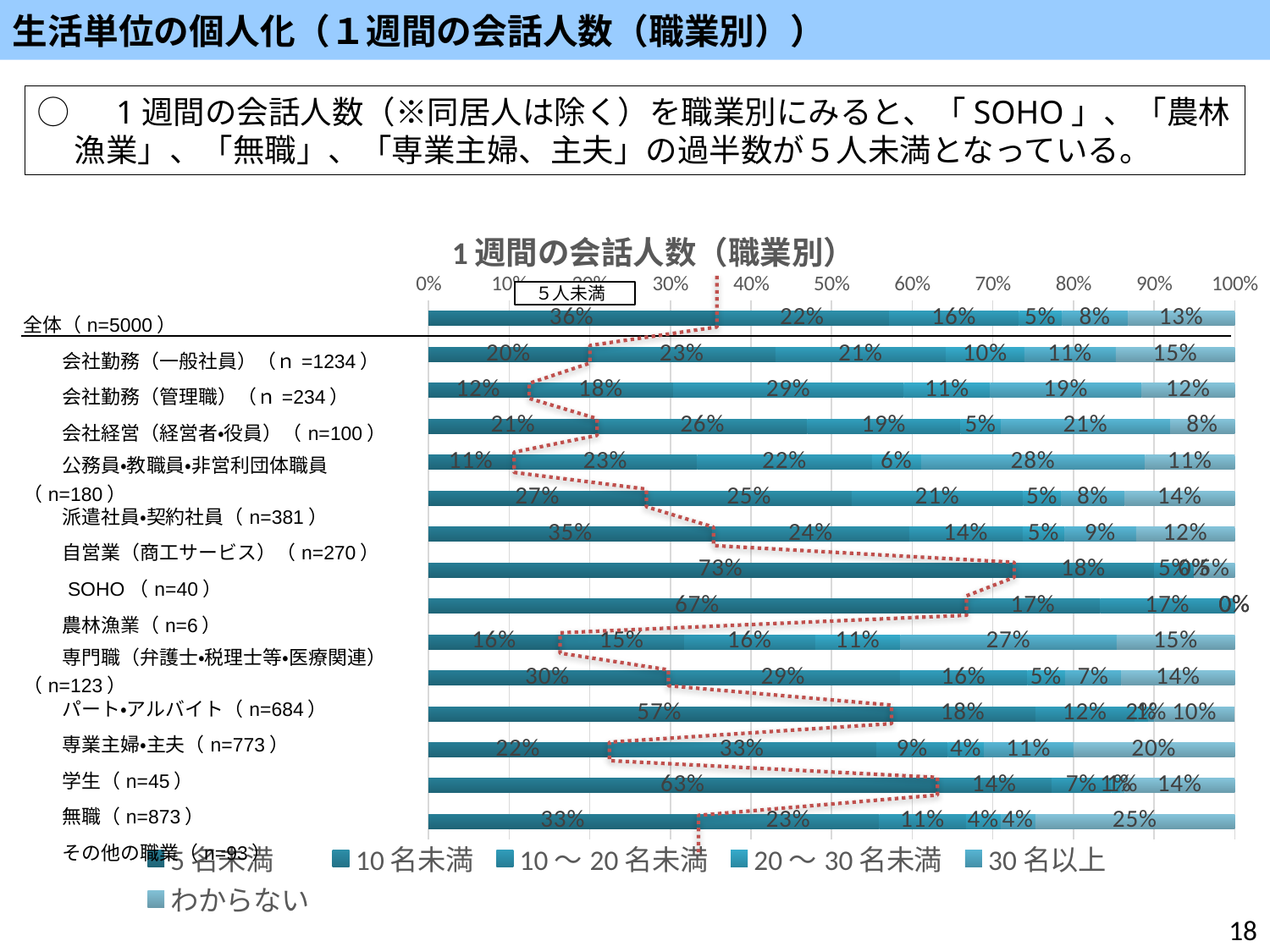
How many occupation categories (bars) are plotted in the chart? 15 What is the value of わからない for 全体 (n=5000)? 13% How many series does the legend list? 6 What is the value of 5名未満 for 全体 (n=5000)? 36% What is the value of 5名未満 for SOHO (n=40)? 73% Is the 5名未満 value for 専業主婦・主夫 greater or less than 50%? greater What is the difference between the 5名未満 value (36%) and the 10名未満 value (22%) for 全体? 14 percentage points What type of chart is shown on the slide? bar chart Which has the larger 5名未満 value, SOHO or 農林漁業? SOHO Which category has the highest value for 5名未満? SOHO What is the value of 5名未満 for 無職 (n=873)? 63% What is the title of the chart? １週間の会話人数（職業別）